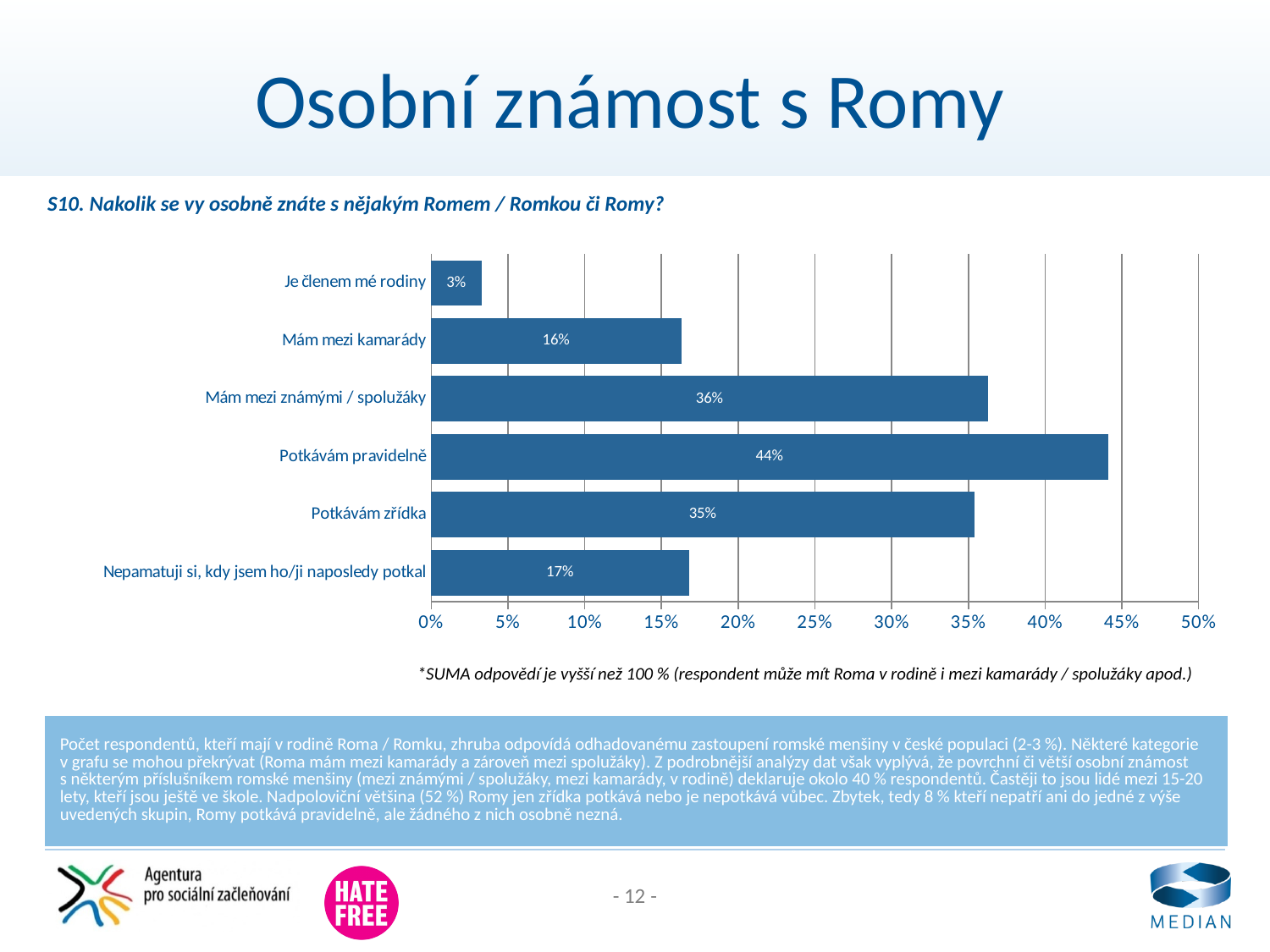
Which category has the highest value? Potkávám pravidelně What is the difference between the values for "Potkávám pravidelně" and "Potkávám zřídka"? 9% What is the maximum value shown on the horizontal axis of the chart? 50% How many categories are shown in the chart? 6 Is the value for "Mám mezi známými / spolužáky" greater or less than 30%? greater What is the value for "Mám mezi známými / spolužáky"? 36% What is the value for "Je členem mé rodiny"? 3% What kind of chart is shown on the slide? bar chart What is the value for "Potkávám pravidelně"? 44% What is the difference between the values for "Mám mezi kamarády" and "Je členem mé rodiny"? 13% Which is larger, the value for "Mám mezi kamarády" or the value for "Nepamatuji si, kdy jsem ho/ji naposledy potkal"? Nepamatuji si, kdy jsem ho/ji naposledy potkal Which category has the lowest value? Je členem mé rodiny